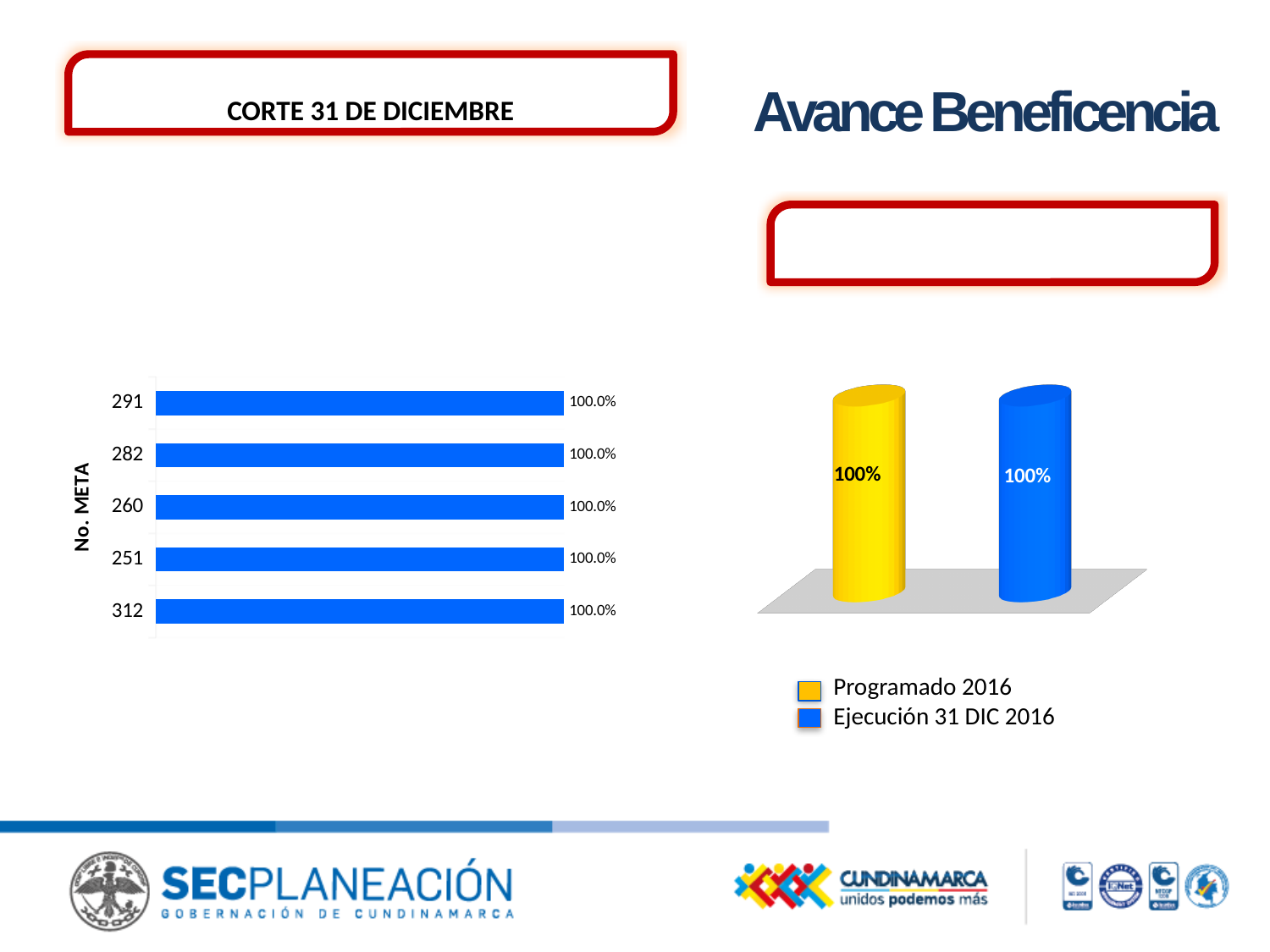
In the right chart, what is the value for Ejecución 31 DIC 2016? 100% What kind of chart is the chart on the left of the slide? Bar chart In the left bar chart, what is the difference between the values for meta 282 and meta 251? 0.0% In the left bar chart, what is the value for meta 291? 100.0% What is the label of the vertical axis in the left bar chart? No. META In the left bar chart, what is the value for meta 260? 100.0% How many categories (metas) are shown in the left bar chart? 5 How many series does the legend of the right chart list? 2 In the right chart, which colour represents Programado 2016? Yellow In the left bar chart, what is the value for meta 312? 100.0% In the right chart, what is the difference between Programado 2016 and Ejecución 31 DIC 2016? 0% In the right chart, what is the value for Programado 2016? 100%